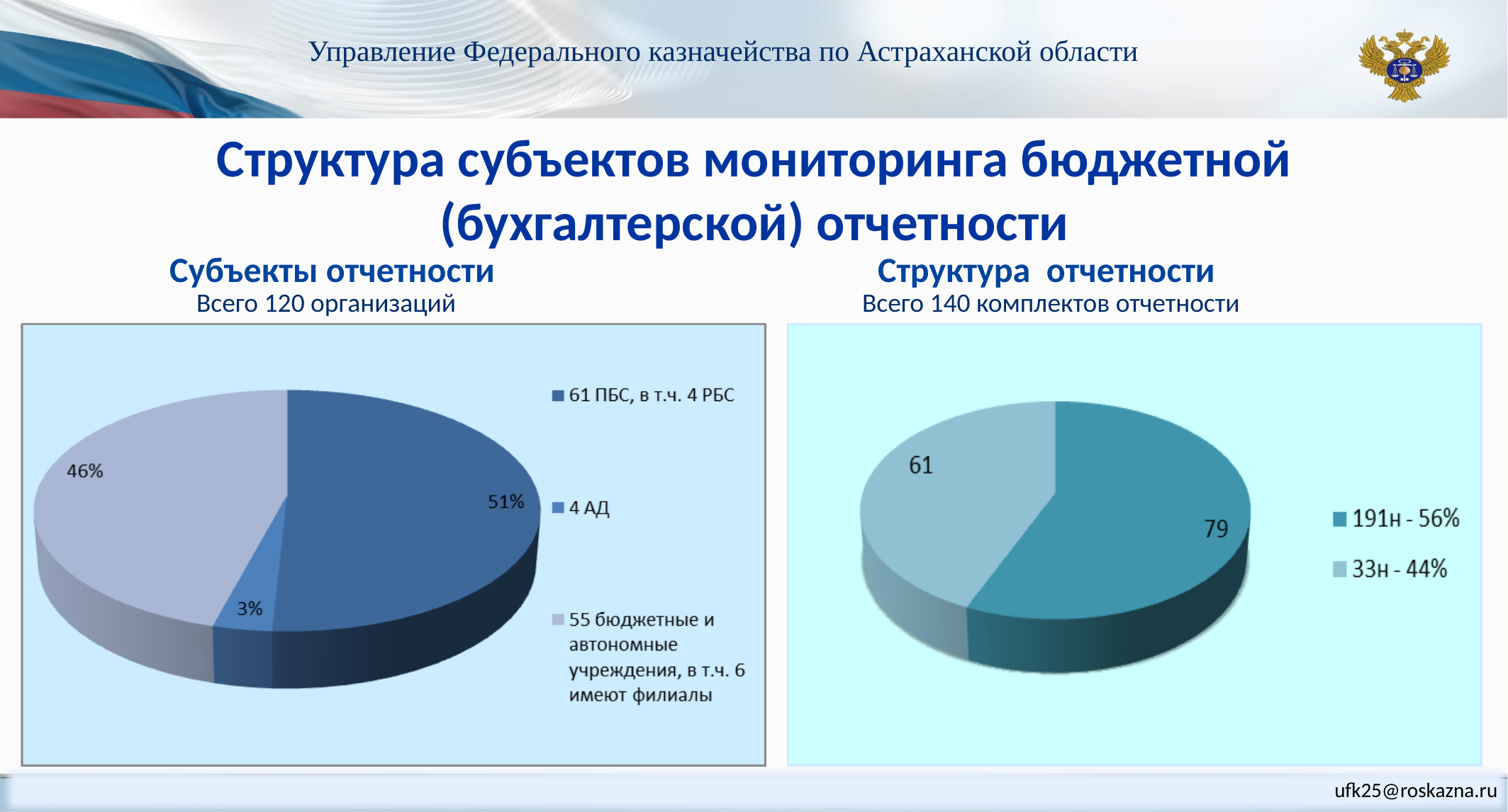
How many slices does the left chart "Субъекты отчетности" have? 3 In the right chart "Структура отчетности", what is the difference between the values for "191н" and "33н"? 18 What type of chart is used on the left under "Субъекты отчетности"? Pie chart In the left chart "Субъекты отчетности", what share is shown for "4 АД"? 3% In the right chart "Структура отчетности", what percentage share does "33н" have according to the legend? 44% In the right chart "Структура отчетности", what value is shown for "191н"? 79 In the left chart "Субъекты отчетности", which category has the largest slice? 61 ПБС, в т.ч. 4 РБС In the left chart "Субъекты отчетности", what share is shown for "55 бюджетные и автономные учреждения, в т.ч. 6 имеют филиалы"? 46% In the left chart "Субъекты отчетности", which category has the smallest slice? 4 АД In the right chart "Структура отчетности", what value is shown for "33н"? 61 How many entries does the legend of the right chart "Структура отчетности" list? 2